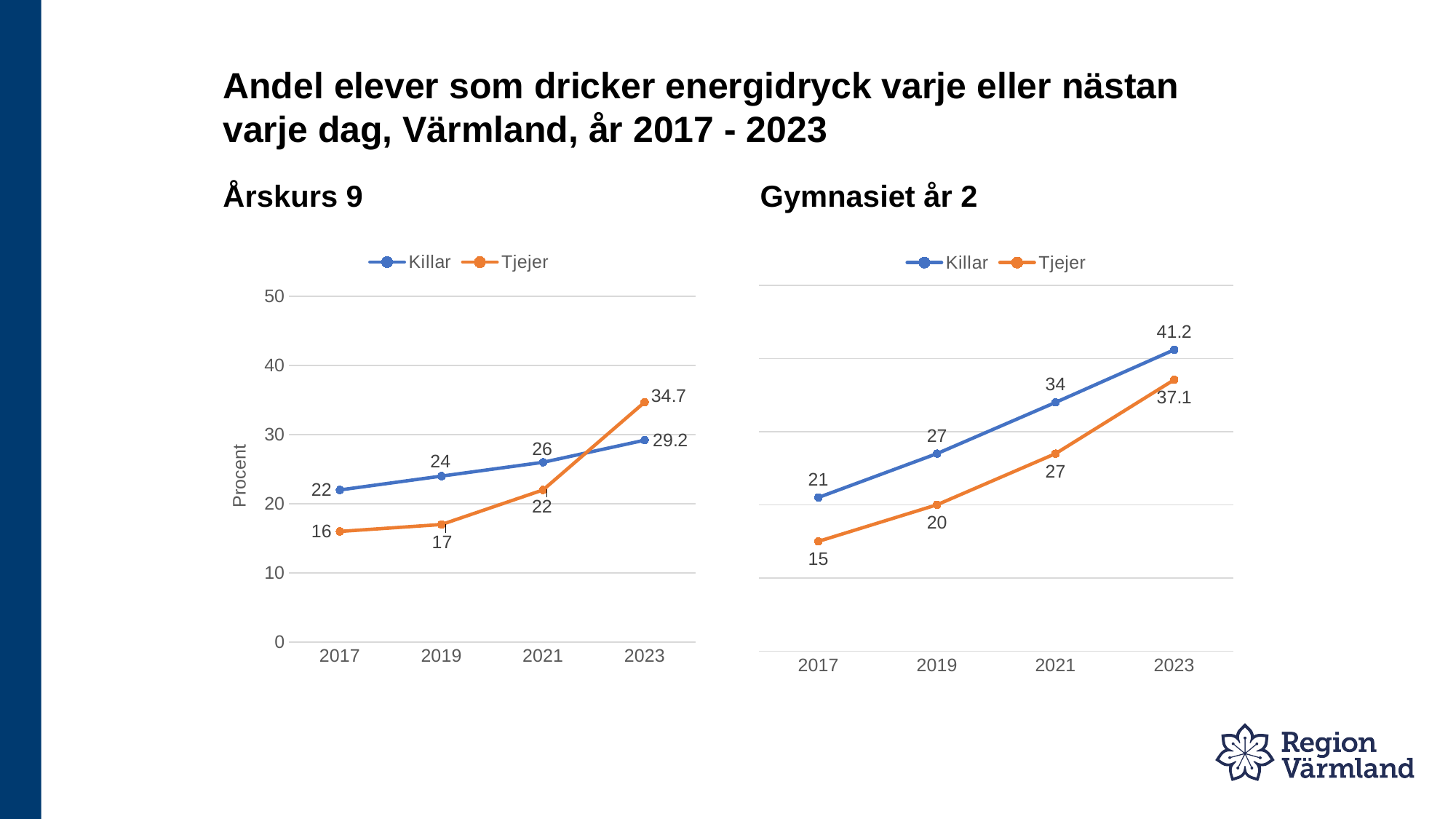
How many series does the legend of the Årskurs 9 chart list? 2 In the Gymnasiet år 2 chart, does the Killar series rise or fall from 2017 to 2023? rise What kind of chart is the Gymnasiet år 2 chart? line chart In the Årskurs 9 chart, which year has the highest value for Tjejer? 2023 In the Gymnasiet år 2 chart, what is the value for Tjejer in 2023? 37.1 In the Årskurs 9 chart, what is the difference between Tjejer and Killar in 2023? 5.5 In the Årskurs 9 chart, what is the value for Killar in 2023? 29.2 In the Årskurs 9 chart, which series has the larger value in 2021, Killar or Tjejer? Killar In the Gymnasiet år 2 chart, what is the difference between Killar and Tjejer in 2017? 6 In the Årskurs 9 chart, what is the value for Tjejer in 2021? 22 In the Gymnasiet år 2 chart, which year has the lowest value for Killar? 2017 In the Gymnasiet år 2 chart, what is the value for Killar in 2019? 27